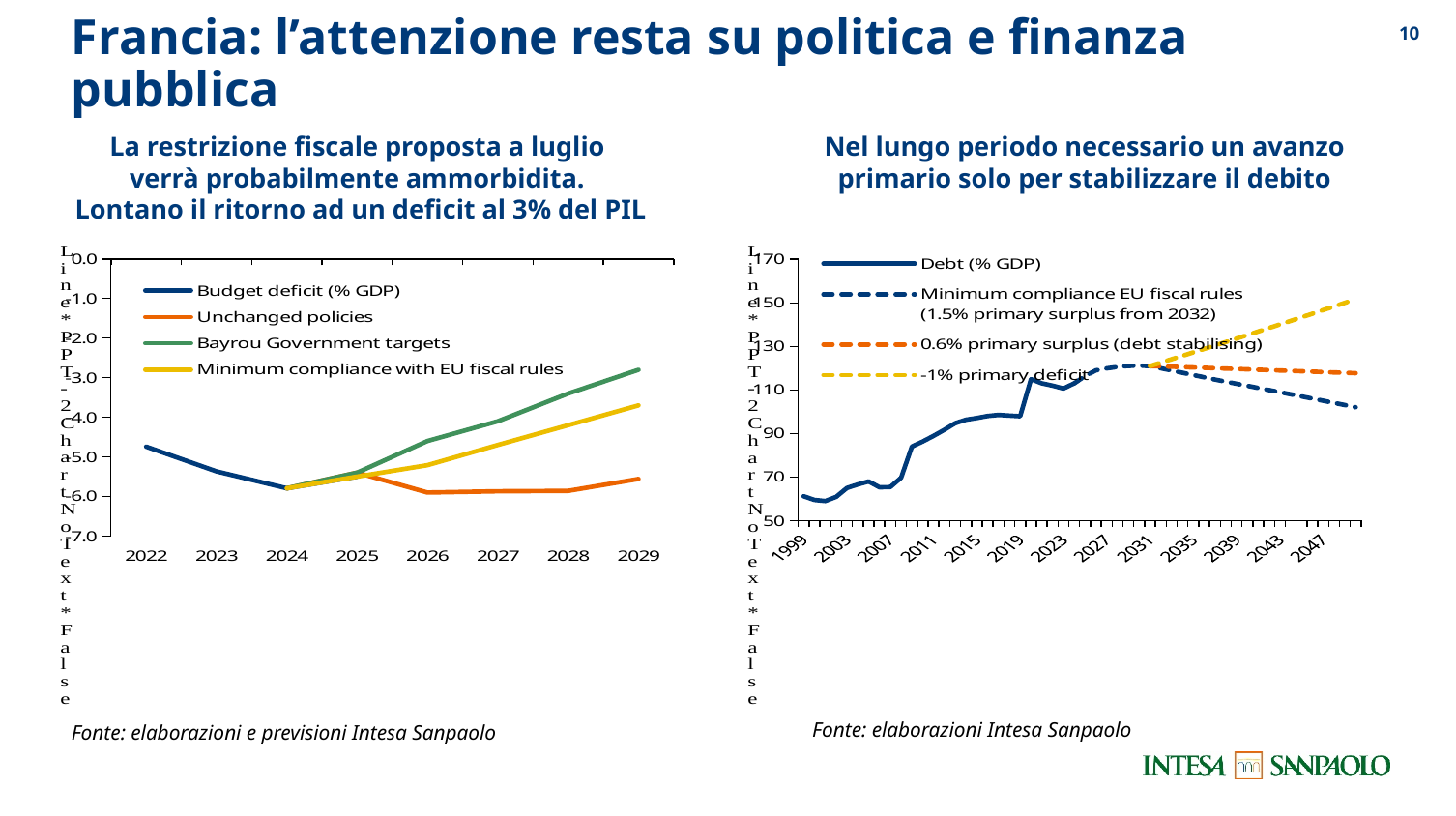
In the right chart, is the value of the -1% primary deficit line in 2047 greater or less than 130? greater How many series does the legend of the right chart list? 4 In the left chart, in 2029 which series is higher (closer to zero): Bayrou Government targets or Unchanged policies? Bayrou Government targets In the right chart, in 2047 which line is higher: -1% primary deficit or Minimum compliance EU fiscal rules? -1% primary deficit In the left chart, which series is shown in orange? Unchanged policies How many years are shown on the x axis of the left chart? 8 In the left chart, does the Budget deficit (% GDP) line rise or fall from 2022 to 2024? Fall In the right chart, is the value of Debt (% GDP) in 1999 greater or less than 70? less In the right chart, does the Minimum compliance EU fiscal rules line rise or fall from 2031 to 2047? Fall What kind of chart is the left chart ("La restrizione fiscale proposta a luglio...")? Line chart How many series does the legend of the left chart list? 4 What kind of chart is the right chart ("Nel lungo periodo necessario un avanzo primario...")? Line chart